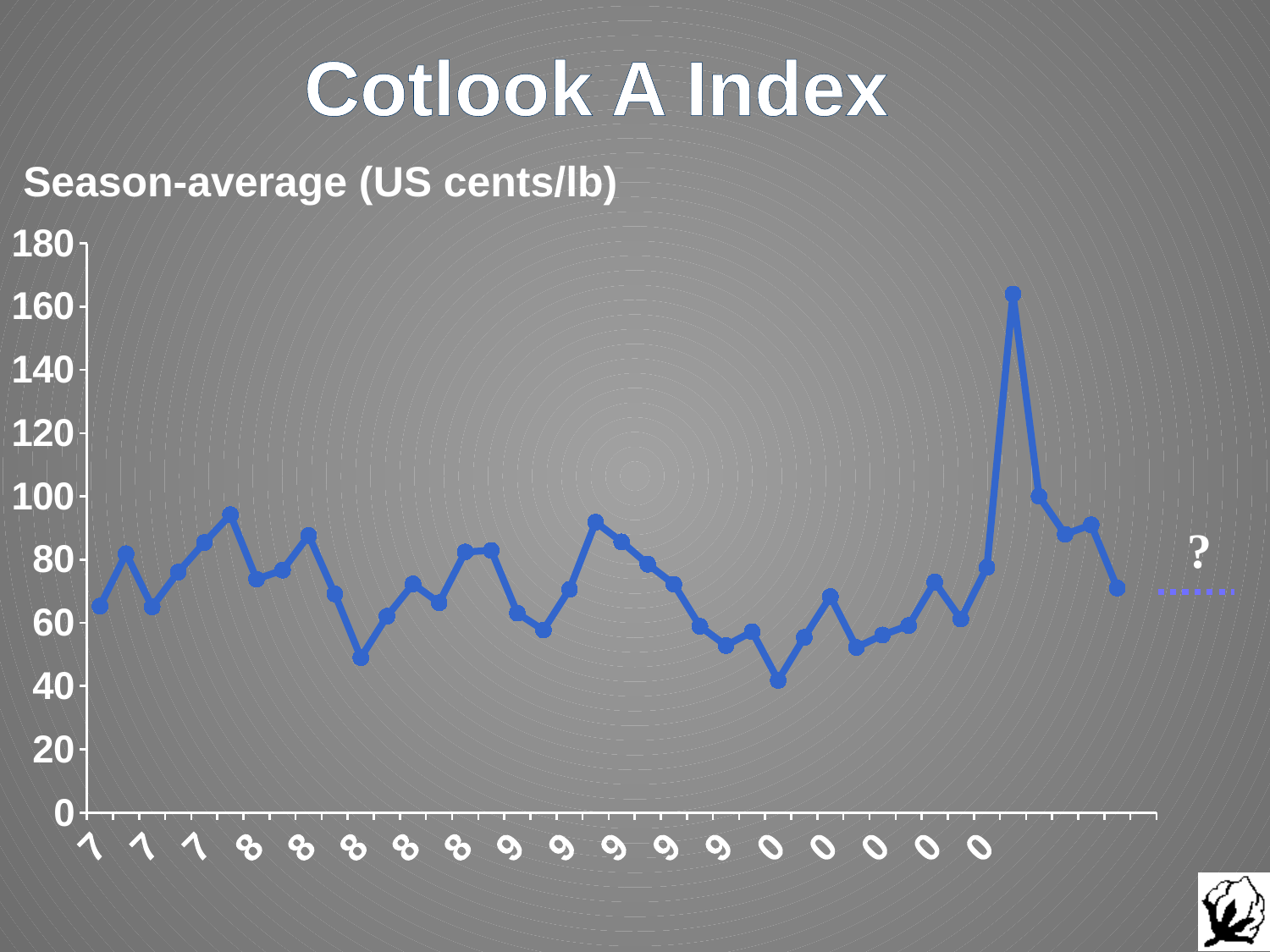
What kind of chart is shown on the slide? line chart Is the highest point on the line greater or less than 140? greater What is the highest value shown on the vertical axis? 180 Is the first point on the line greater or less than 80? less Is the last plotted point on the line greater or less than 100? less How many data series are plotted on the chart? 1 After the highest point on the line, do the values rise or fall? fall What is the title of the chart? Cotlook A Index In what units are the values on the chart expressed? US cents/lb